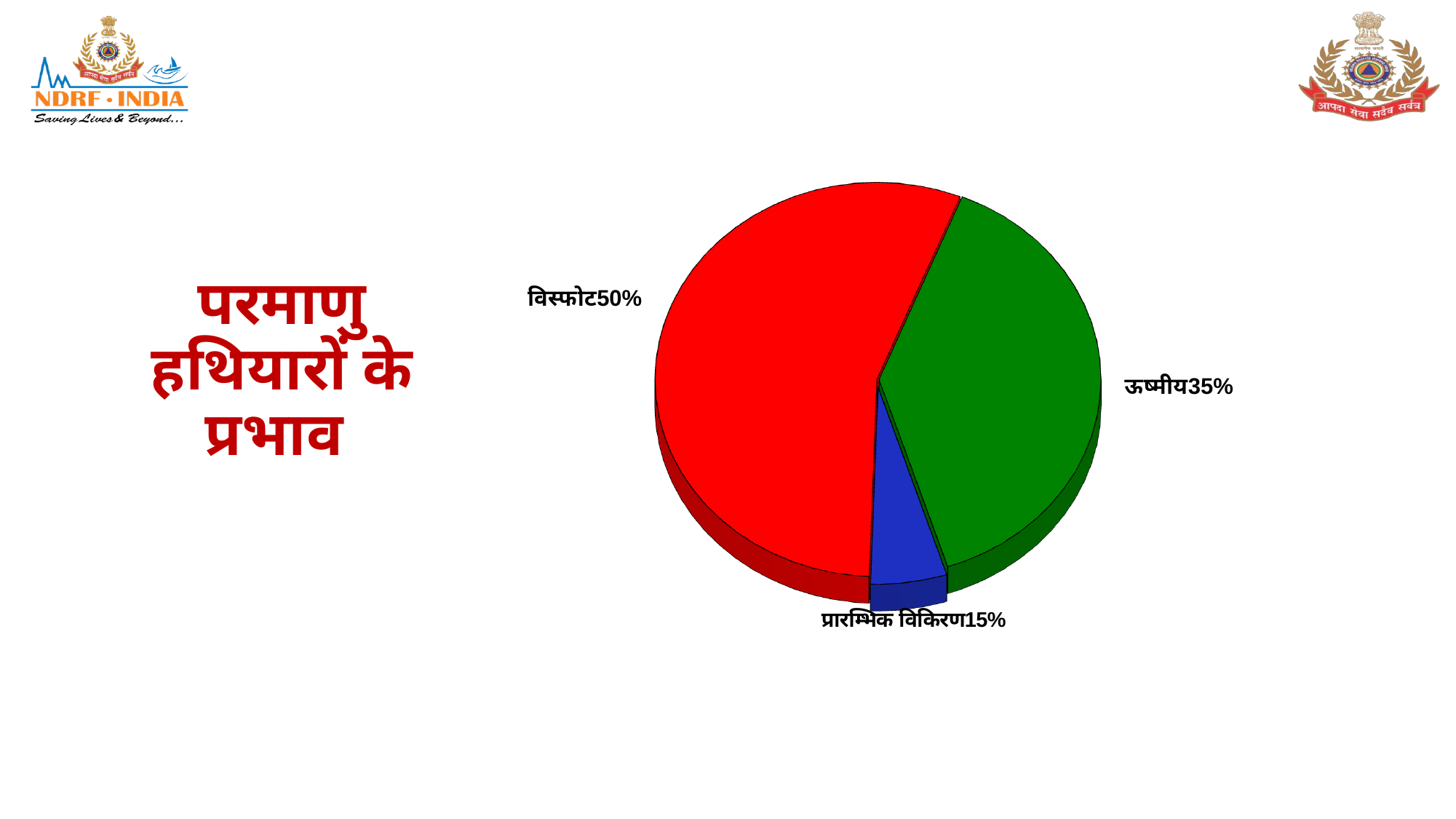
Which is larger, the share of ऊष्मीय or the share of प्रारम्भिक विकिरण? ऊष्मीय What kind of chart is shown on the slide? pie chart What is the difference between the shares of ऊष्मीय and प्रारम्भिक विकिरण? 20% What is the difference between the shares of विस्फोट and ऊष्मीय? 15% What is the title text shown to the left of the chart? परमाणु हथियारों के प्रभाव Which category has the smallest slice of the pie? प्रारम्भिक विकिरण How many slices does the pie chart have? 3 What share of the pie does विस्फोट have? 50% What share of the pie does ऊष्मीय have? 35% What colour is the slice for ऊष्मीय? green Which category has the largest slice of the pie? विस्फोट What share of the pie does प्रारम्भिक विकिरण have? 15%